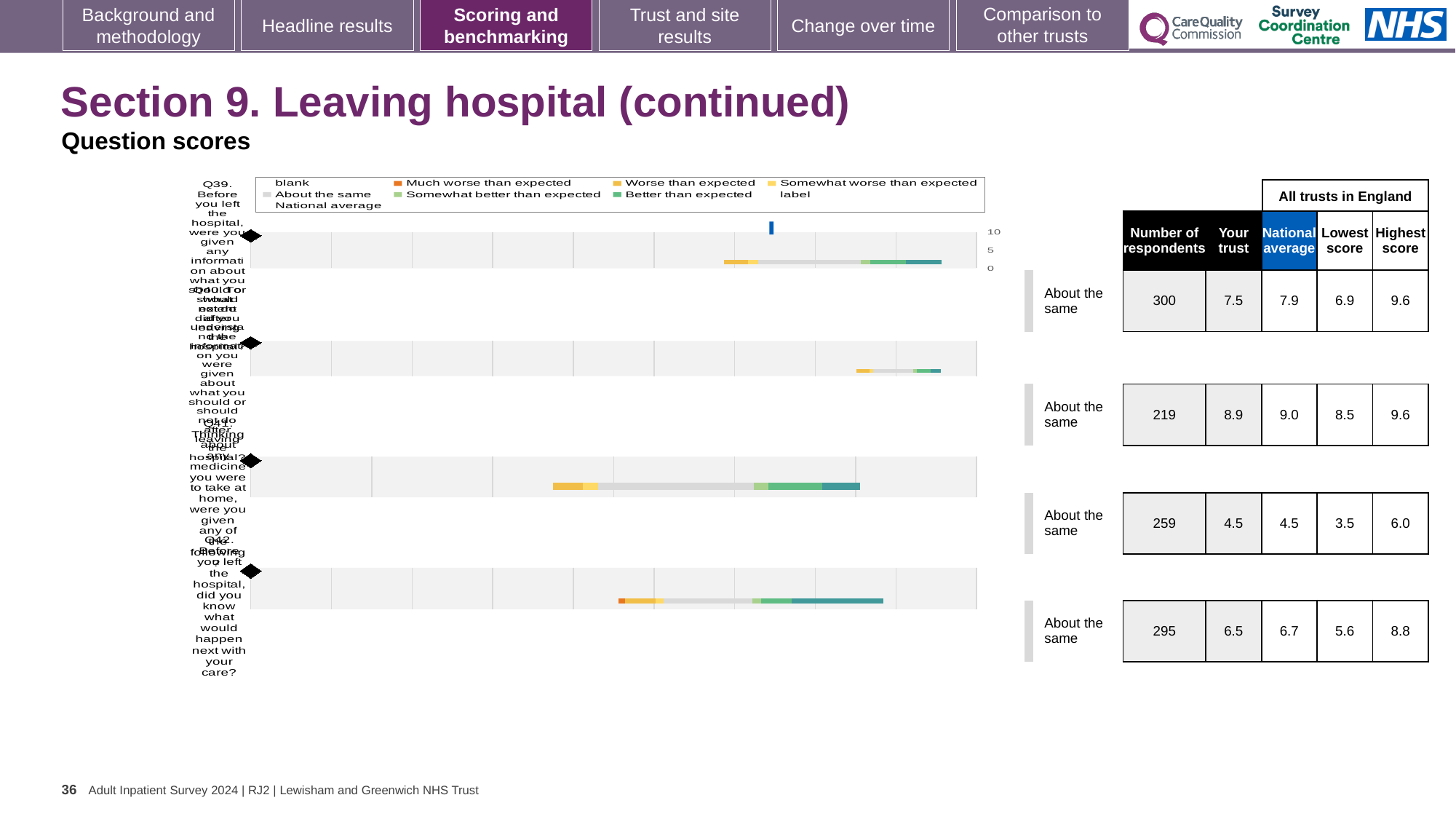
For Q42 (the last row), which is larger: the 'Your trust' score or the national average? national average Which row has the highest 'Your trust' score? the second row (8.9) What is the lowest score among all trusts in England for the third row? 3.5 For Q39 (the first row), what is the difference between the highest score and the lowest score among all trusts in England? 2.7 For the third row, what is the difference between the highest score (6.0) and the lowest score (3.5)? 2.5 What kind of chart is used to show the question scores on this slide? bar chart What benchmark label is shown next to each of the four questions? About the same How many respondents are listed for Q42 (the last row)? 295 How many questions (rows) are plotted in the chart? 4 What is the 'Your trust' score for Q39 (the first row)? 7.5 Which row has the lowest 'Your trust' score? the third row (4.5) What is the national average for Q39 (the first row)? 7.9